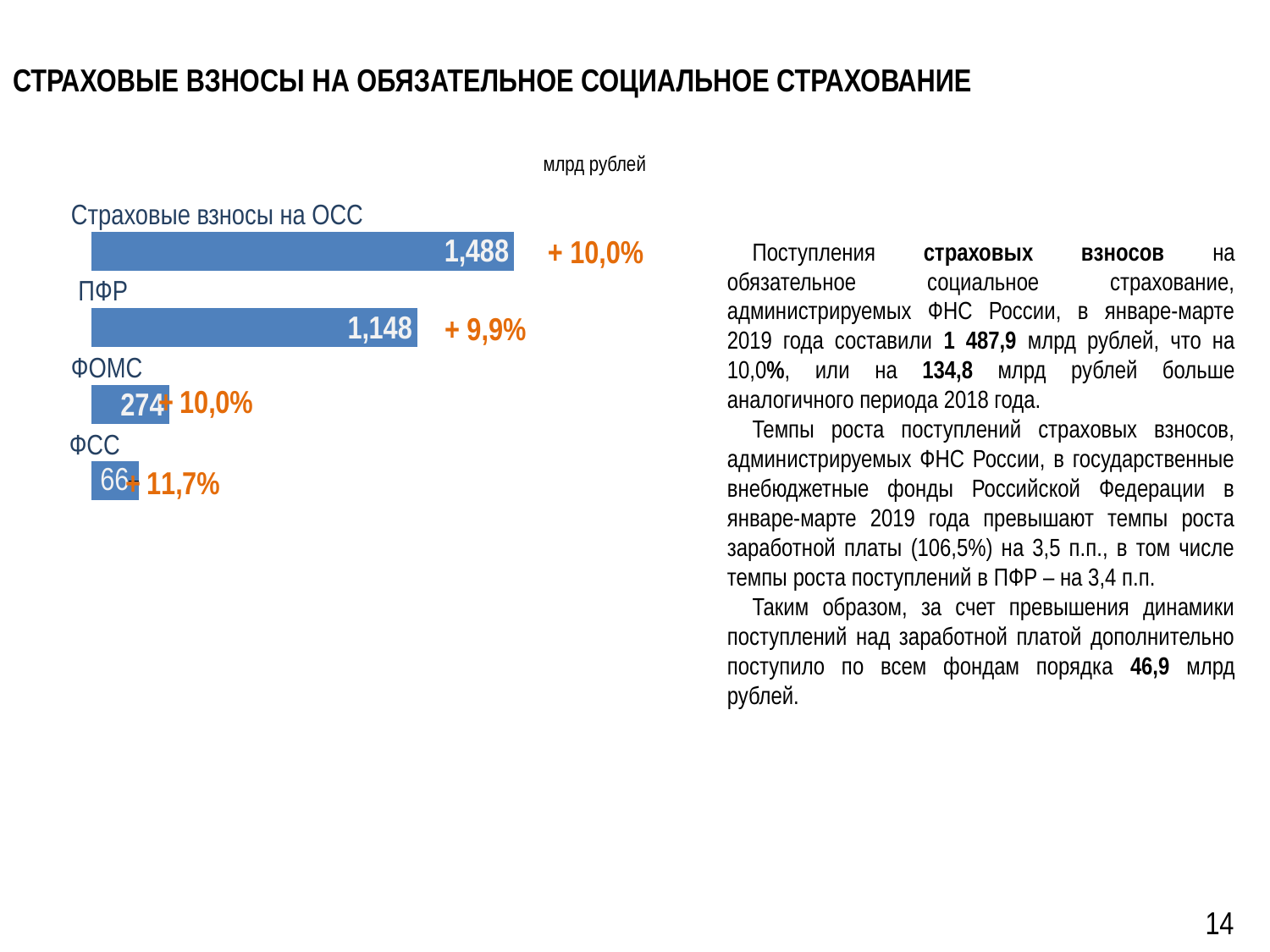
What value is shown for Страховые взносы на ОСС on the chart? 1,488 What growth percentage is shown next to the ФСС bar? + 11,7% Which category has the largest bar on the chart? Страховые взносы на ОСС How many bars are shown on the chart? 4 Which category has the smallest bar on the chart? ФСС What value is shown for ФСС on the chart? 66 What value is shown for ФОМС on the chart? 274 What type of chart is shown on the slide? Bar chart What is the difference between the values for ПФР and ФОМС? 874 What value is shown for ПФР on the chart? 1,148 Which is larger, the value for ФОМС or the value for ФСС? ФОМС What growth percentage is shown next to the ПФР bar? + 9,9%